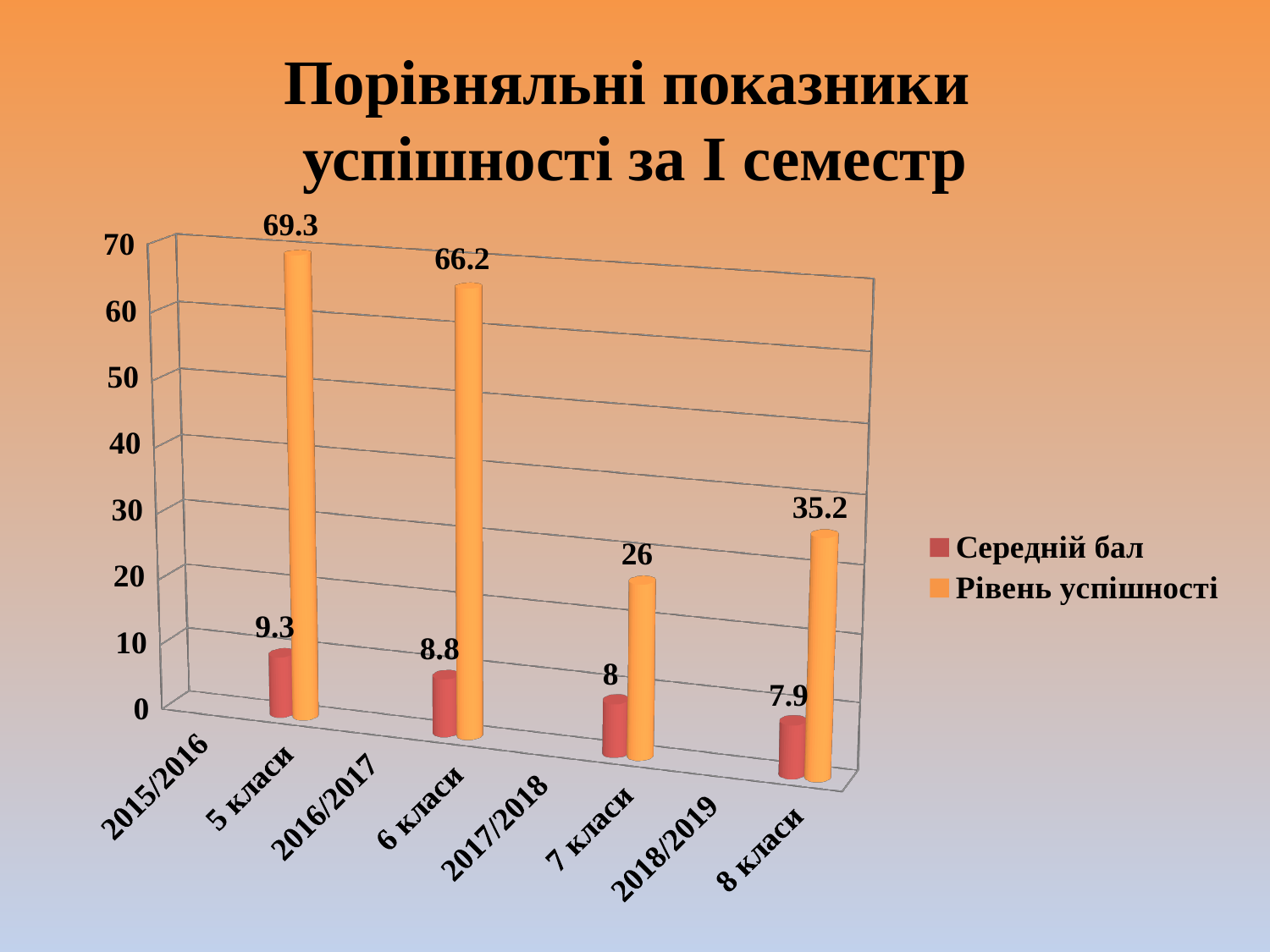
What is the value of Середній бал for 2016/2017 (6 класи)? 8.8 What is the value of Рівень успішності for 2015/2016 (5 класи)? 69.3 Which category has the highest Рівень успішності? 2015/2016 (5 класи) Does Середній бал rise or fall from 2015/2016 to 2018/2019? Falls What is the difference between Рівень успішності for 2015/2016 (5 класи) and 2016/2017 (6 класи)? 3.1 What is the value of Рівень успішності for 2017/2018 (7 класи)? 26 How many series does the legend list? 2 What is the value of Середній бал for 2018/2019 (8 класи)? 7.9 Which is larger: Рівень успішності for 2017/2018 (7 класи) or for 2018/2019 (8 класи)? 2018/2019 (8 класи) How many categories are shown on the x axis? 8 Which category has the lowest Середній бал? 2018/2019 (8 класи) What kind of chart is shown on the slide? Bar chart